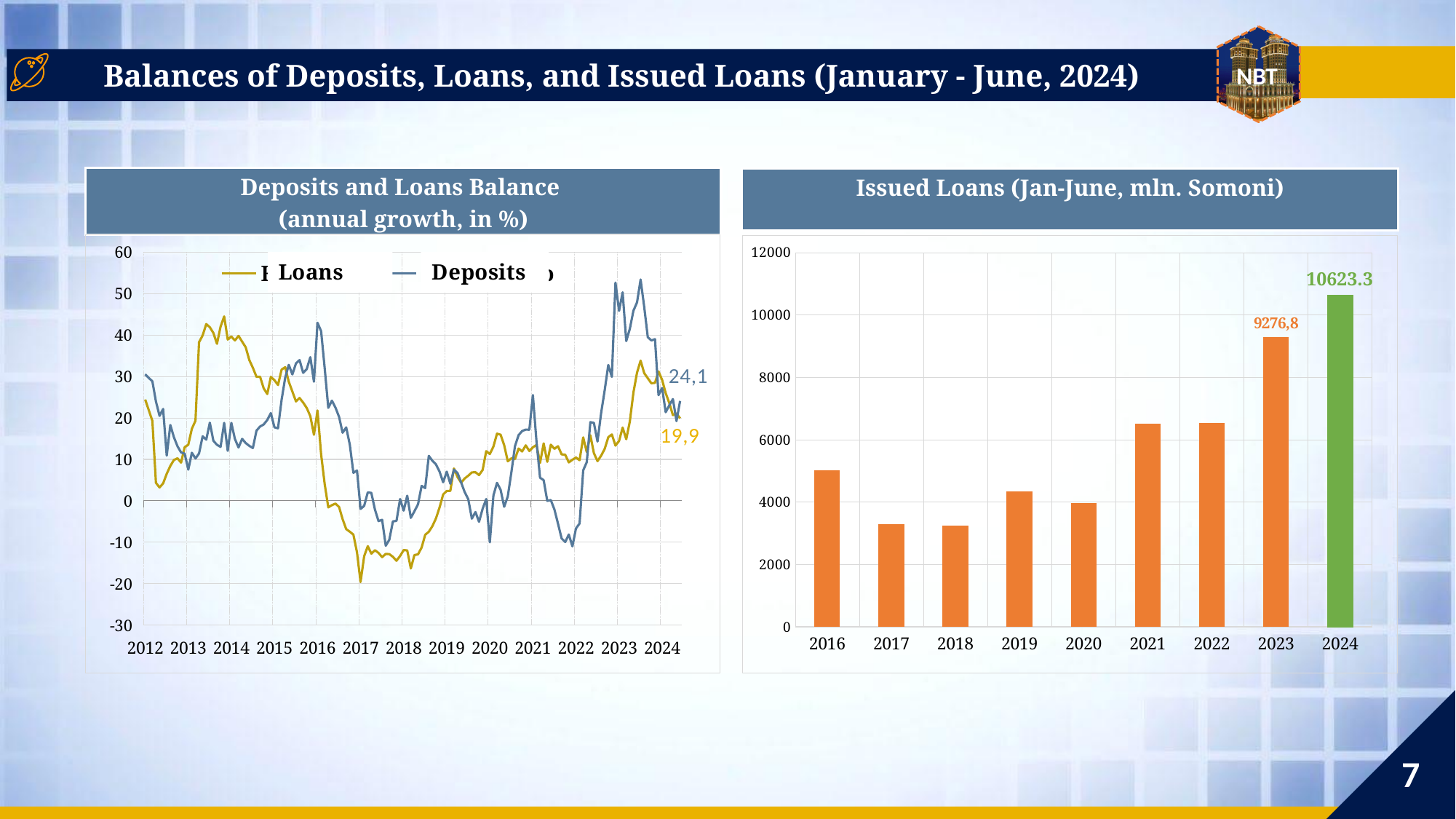
In the Issued Loans (Jan-June, mln. Somoni) chart, which year has the highest value? 2024 In the Issued Loans (Jan-June, mln. Somoni) chart, which is larger, the value for 2019 or the value for 2020? 2019 In the Issued Loans (Jan-June, mln. Somoni) chart, what colour is the bar for 2024? green How many series does the legend of the Deposits and Loans Balance (annual growth, in %) chart list? 2 In the Issued Loans (Jan-June, mln. Somoni) chart, is the value for 2016 greater or less than 4000? greater In the Issued Loans (Jan-June, mln. Somoni) chart, how many years are shown on the x axis? 9 In the Issued Loans (Jan-June, mln. Somoni) chart, what is the value for 2024? 10623.3 In the Issued Loans (Jan-June, mln. Somoni) chart, is the value for 2018 greater or less than 4000? less In the Deposits and Loans Balance (annual growth, in %) chart, what is the last labelled value for Deposits? 24,1 In the Deposits and Loans Balance (annual growth, in %) chart, what is the last labelled value for Loans? 19,9 In the Issued Loans (Jan-June, mln. Somoni) chart, what is the value for 2023? 9276,8 What kind of chart is the Issued Loans (Jan-June, mln. Somoni) chart? bar chart